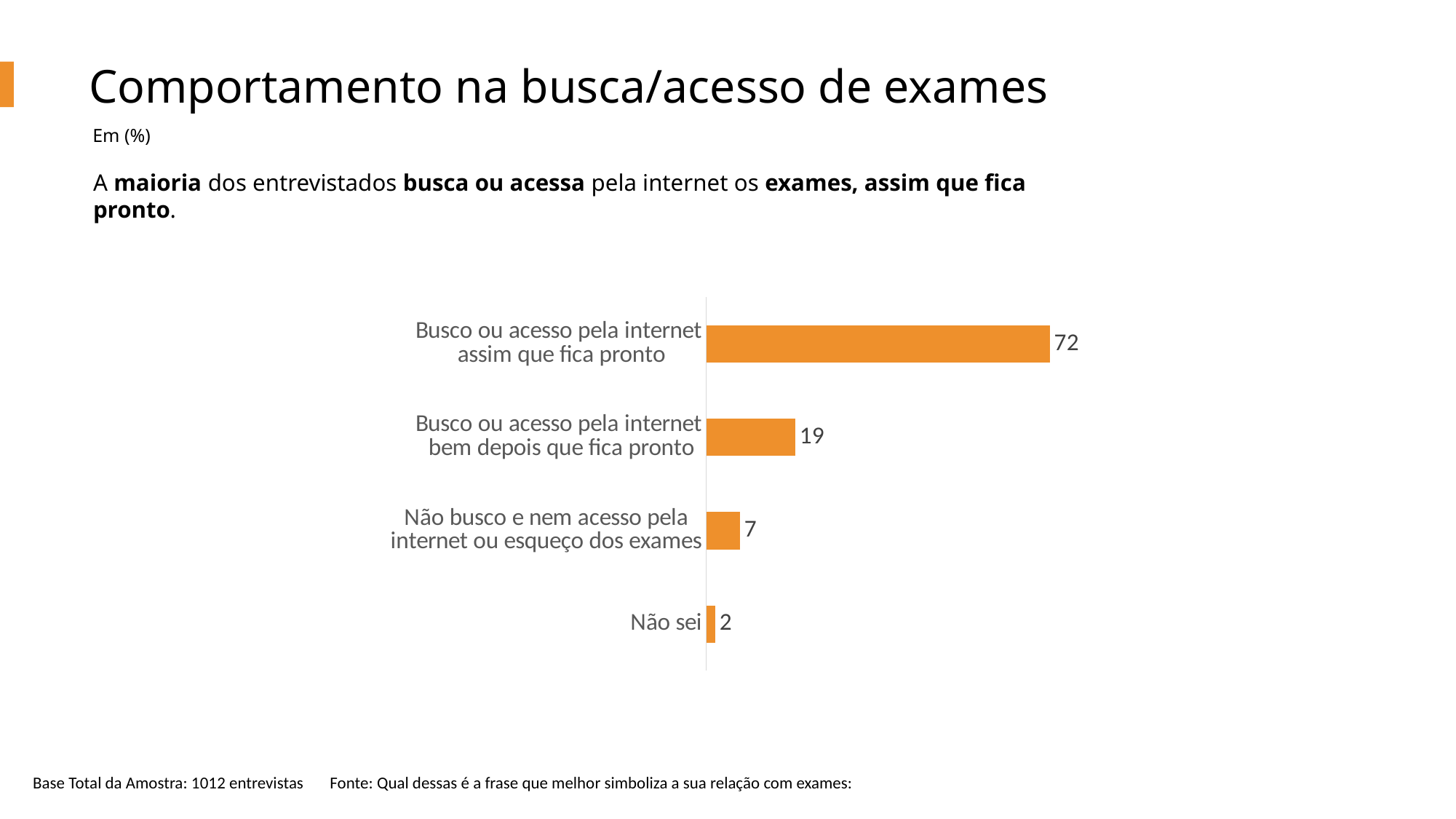
Which category has the highest value? Busco ou acesso pela internet assim que fica pronto How many categories are shown in the chart? 4 What is the difference between "Busco ou acesso pela internet assim que fica pronto" and "Busco ou acesso pela internet bem depois que fica pronto"? 53 What is the value for "Não sei"? 2 What is the difference between "Não busco e nem acesso pela internet ou esqueço dos exames" and "Não sei"? 5 What is the value for "Busco ou acesso pela internet bem depois que fica pronto"? 19 What kind of chart is shown on the slide? Bar chart What colour are the bars in the chart? Orange What is the value for "Não busco e nem acesso pela internet ou esqueço dos exames"? 7 What is the value for "Busco ou acesso pela internet assim que fica pronto"? 72 Which category has the lowest value? Não sei Which is larger: "Busco ou acesso pela internet bem depois que fica pronto" or "Não busco e nem acesso pela internet ou esqueço dos exames"? Busco ou acesso pela internet bem depois que fica pronto